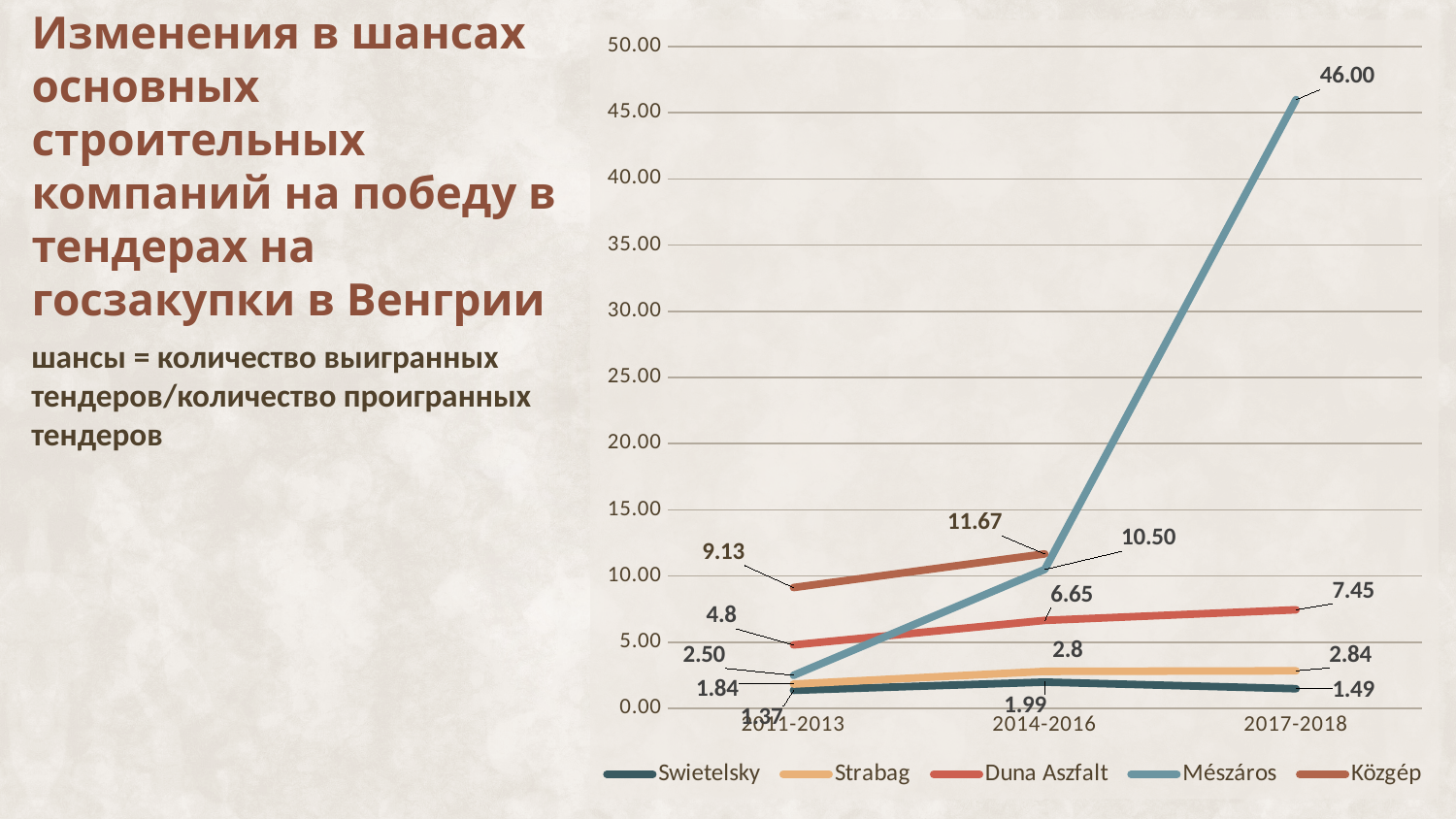
Which series is drawn in red? Duna Aszfalt Which company has the lowest value in 2011-2013? Swietelsky In 2014-2016, which is larger: Közgép or Mészáros? Közgép What is the value for Mészáros in 2017-2018? 46.00 Does the Mészáros line rise or fall from 2011-2013 to 2017-2018? rises What is the value for Közgép in 2011-2013? 9.13 How many periods are shown on the x axis? 3 What is the difference between the Mészáros values in 2017-2018 and 2014-2016? 35.50 What is the value for Duna Aszfalt in 2014-2016? 6.65 Which company has the highest value in 2017-2018? Mészáros How many series does the legend list? 5 What type of chart is shown on the slide? line chart